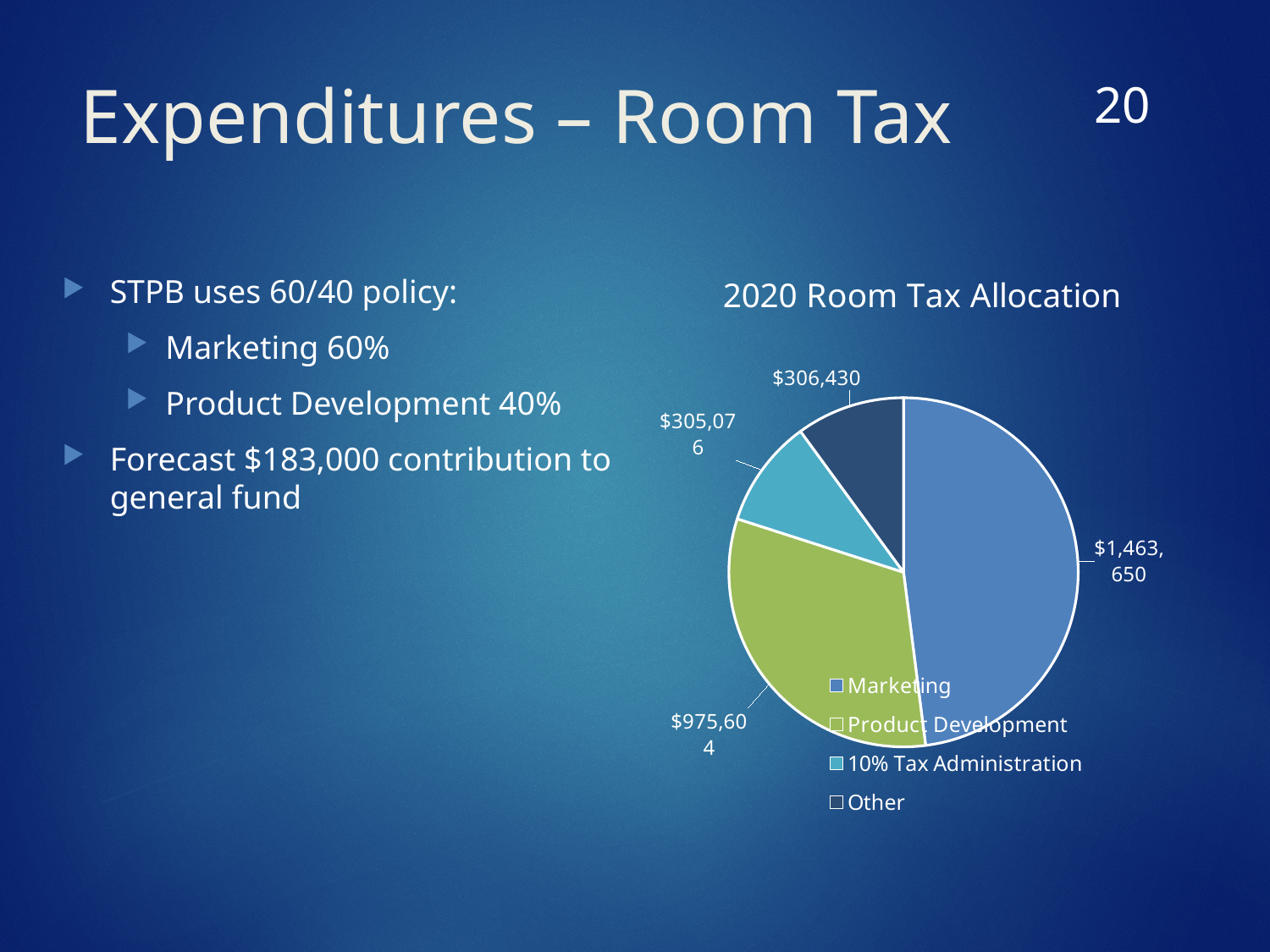
What is the value of the Marketing slice? $1,463,650 Which category has the largest slice of the pie? Marketing What is the value of the Other slice? $306,430 What is the value of the 10% Tax Administration slice? $305,076 How many entries does the chart legend list? 4 What type of chart is shown on the slide? pie chart What is the value of the Product Development slice? $975,604 Which is larger, Marketing or Product Development? Marketing What is the title of the chart? 2020 Room Tax Allocation How many slices does the pie chart have? 4 What is the difference between the Marketing and Product Development values? $488,046